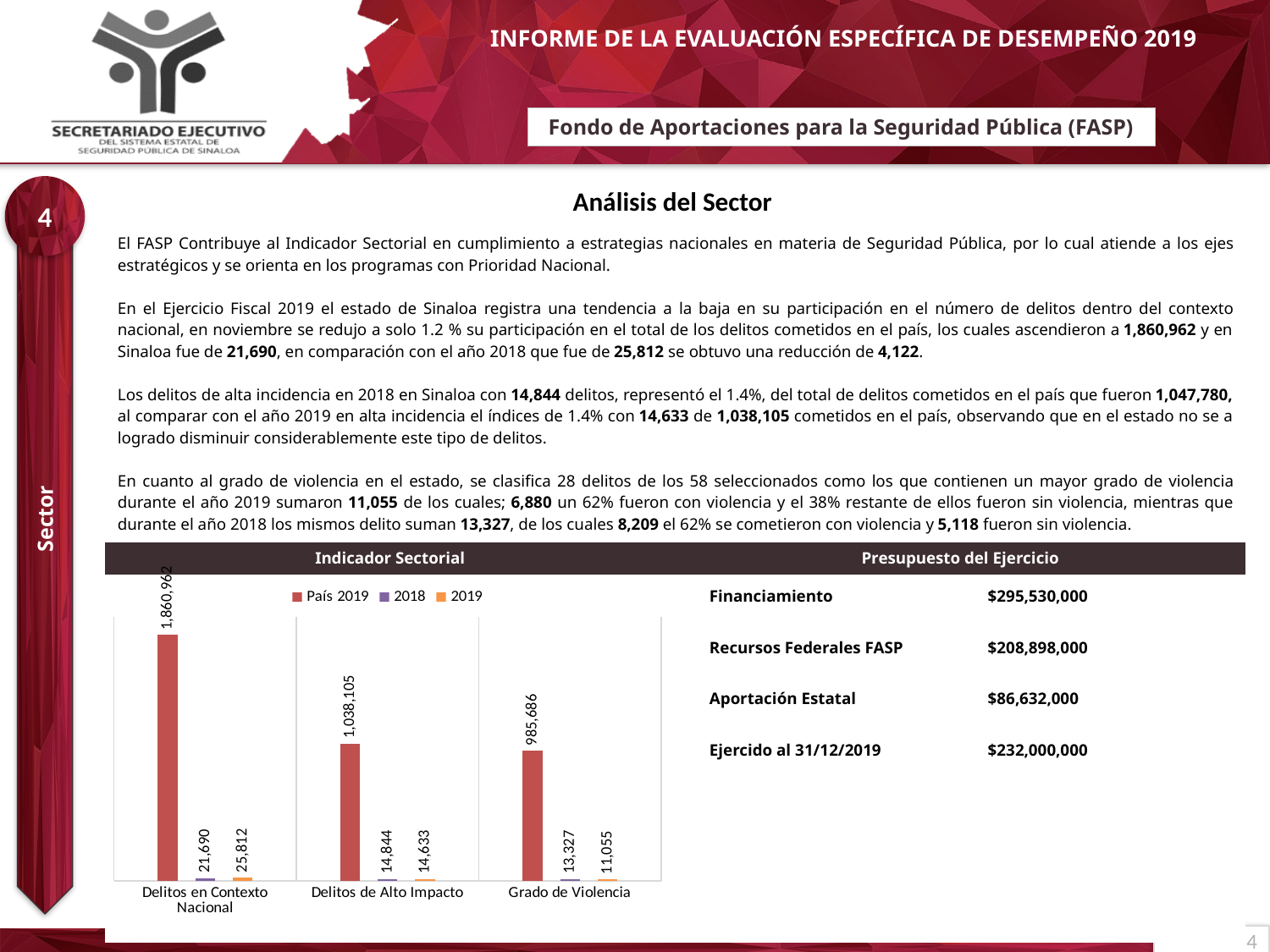
In the 'Indicador Sectorial' chart, what is the value of the '2018' series for 'Delitos de Alto Impacto'? 14,844 How many categories are shown on the x axis of the 'Indicador Sectorial' chart? 3 In the 'Indicador Sectorial' chart, what is the value of 'País 2019' for 'Grado de Violencia'? 985,686 In the 'Indicador Sectorial' chart, what is the value of the '2019' series for 'Grado de Violencia'? 11,055 In the 'Indicador Sectorial' chart, for 'Delitos de Alto Impacto', which is larger: the '2018' value or the '2019' value? 2018 In the 'Indicador Sectorial' chart, do the 'País 2019' values rise or fall from left to right across the categories? Fall How many series does the legend of the 'Indicador Sectorial' chart list? 3 In the 'Indicador Sectorial' chart, what is the value of 'País 2019' for 'Delitos de Alto Impacto'? 1,038,105 What kind of chart is shown under the heading 'Indicador Sectorial'? Bar chart In the 'Indicador Sectorial' chart, what is the value of 'País 2019' for 'Delitos en Contexto Nacional'? 1,860,962 In the 'Indicador Sectorial' chart, what is the difference between the '2018' and '2019' values for 'Grado de Violencia'? 2,272 In the 'Indicador Sectorial' chart, which category has the highest 'País 2019' value? Delitos en Contexto Nacional